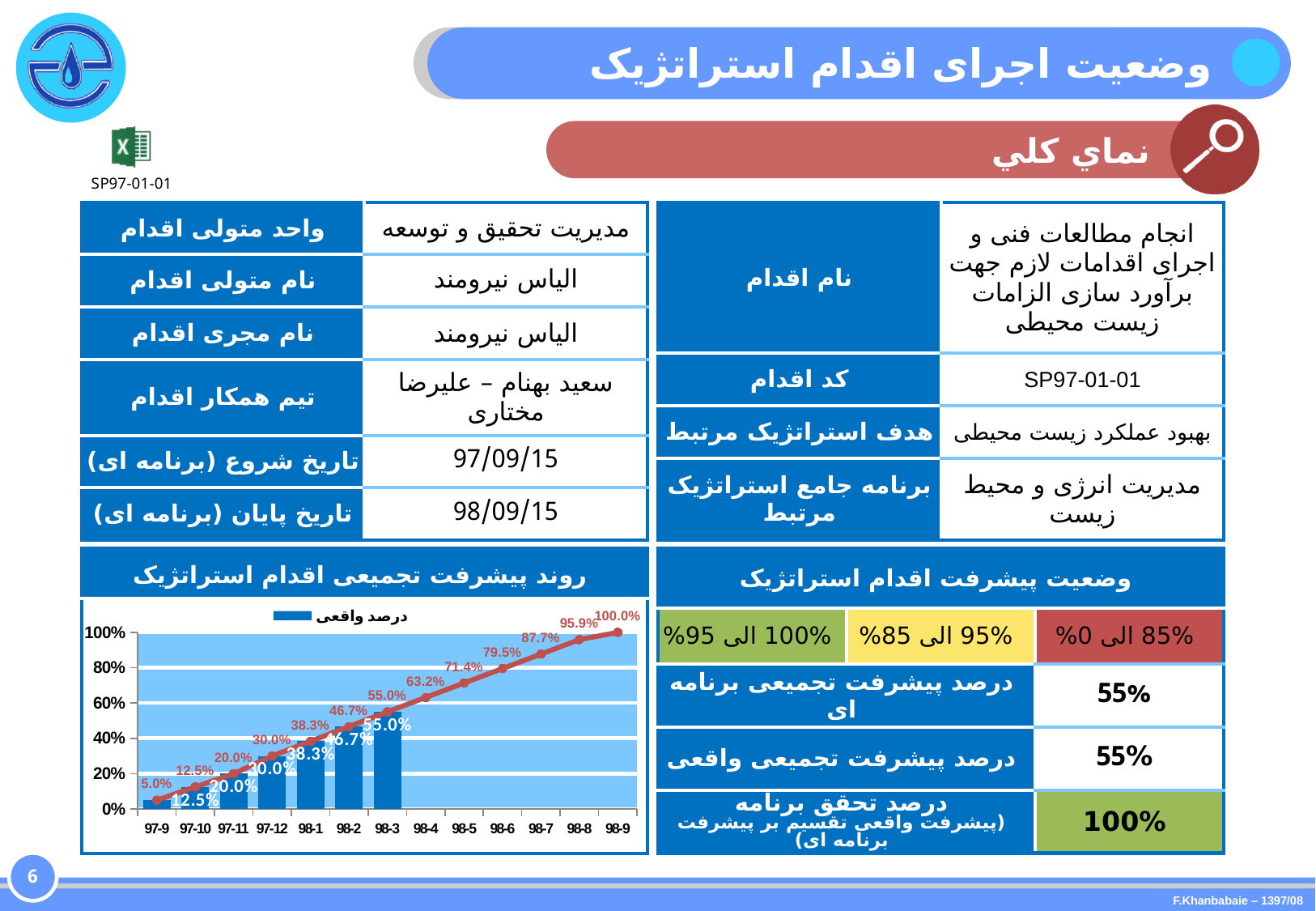
What is the value of the line series at 97-9? 5.0% What is the value of the line series at 98-9? 100.0% What is the value of the bar (درصد واقعی) at 98-3? 55.0% What is the value of the bar (درصد واقعی) at 97-12? 30.0% Which category has the highest value on the line series? 98-9 What is the difference between the line values at 98-9 and 98-8? 4.1% Which category has the lowest value on the line series? 97-9 What is the value of the line series at 98-5? 71.4% How many categories are shown on the x axis? 13 What is the legend entry shown for the bar series? درصد واقعی What kind of chart is shown on the slide? A combined bar and line chart Do the line values rise or fall from 97-9 to 98-9? Rise